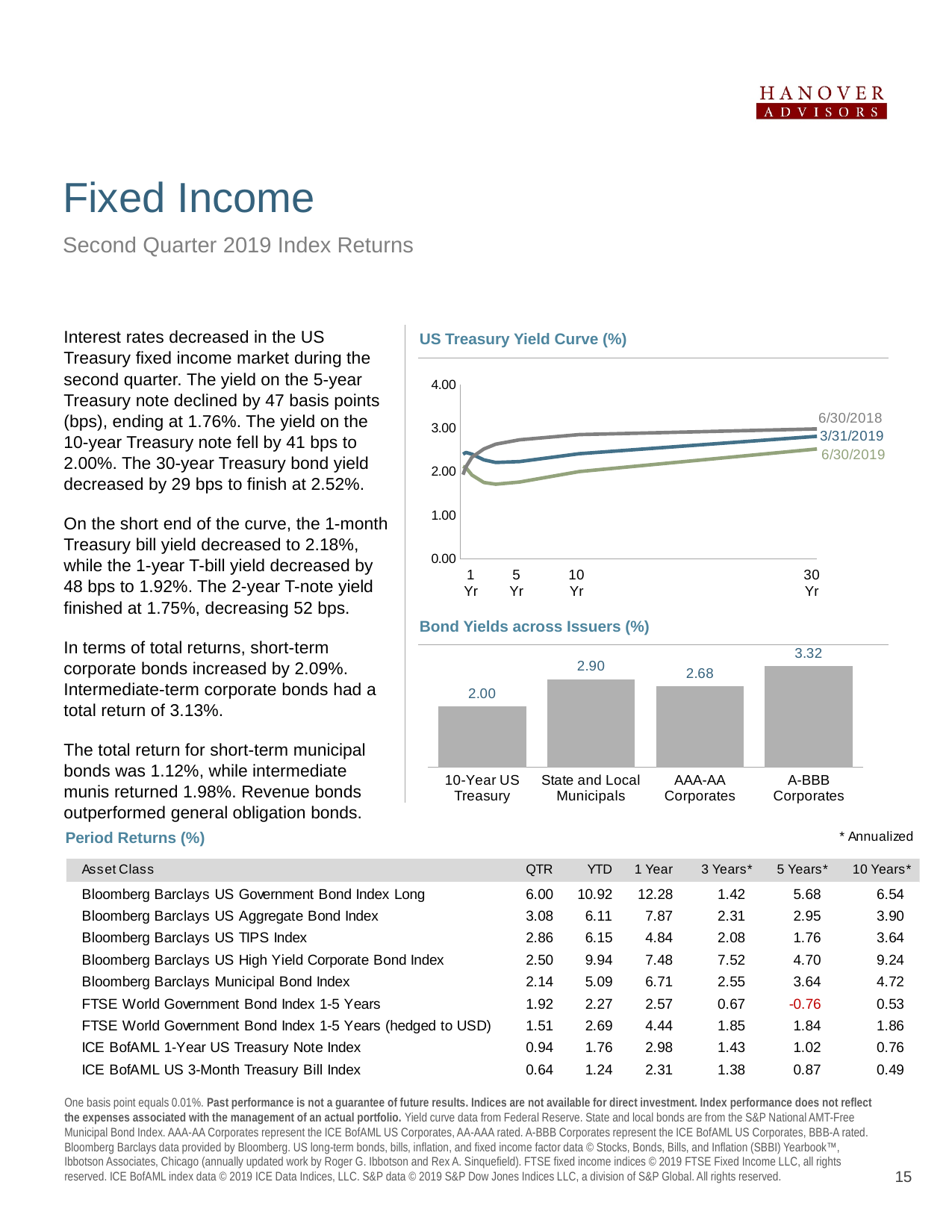
In the Bond Yields across Issuers (%) chart, which is larger: the yield for State and Local Municipals or for AAA-AA Corporates? State and Local Municipals In the Bond Yields across Issuers (%) chart, what is the yield for State and Local Municipals? 2.90 How many issuer categories are shown in the Bond Yields across Issuers (%) chart? 4 In the Bond Yields across Issuers (%) chart, which issuer has the highest yield? A-BBB Corporates In the US Treasury Yield Curve (%) chart, is the 6/30/2019 value at 30 Yr greater or less than 3.00? less In the Bond Yields across Issuers (%) chart, what is the difference between the A-BBB Corporates yield and the 10-Year US Treasury yield? 1.32 In the Bond Yields across Issuers (%) chart, what is the yield for the 10-Year US Treasury? 2.00 How many series (dates) are plotted in the US Treasury Yield Curve (%) chart? 3 In the US Treasury Yield Curve (%) chart, which series is highest at the 30 Yr maturity? 6/30/2018 In the Bond Yields across Issuers (%) chart, which issuer has the lowest yield? 10-Year US Treasury What kind of chart is the Bond Yields across Issuers (%) chart? Bar chart In the Bond Yields across Issuers (%) chart, what is the yield for AAA-AA Corporates? 2.68